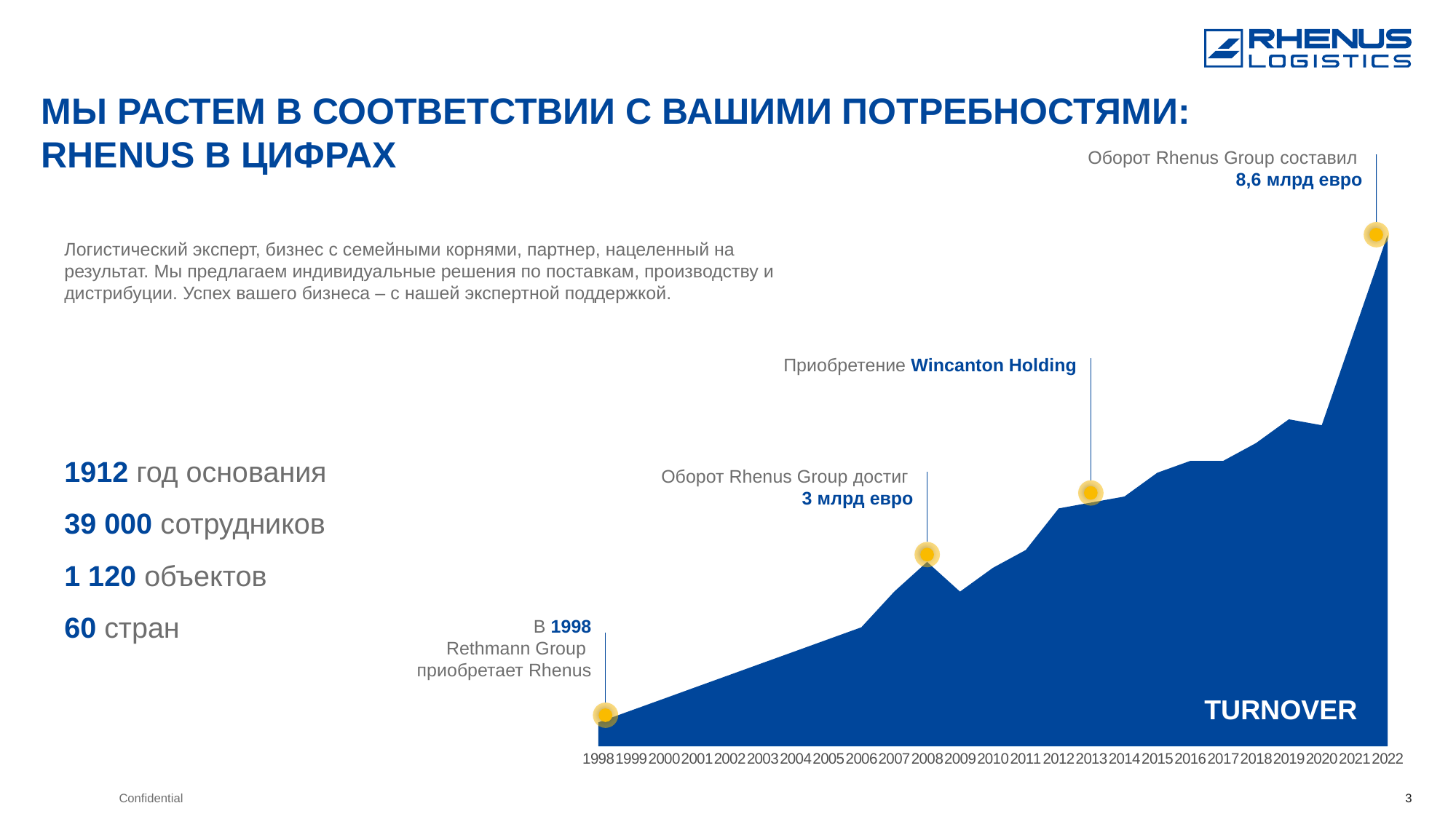
In which year is the acquisition of Wincanton Holding marked on the chart? 2013 What turnover did Rhenus Group reach in 2008 according to the annotation? 3 млрд евро Which year has the lowest turnover on the chart? 1998 What was the Rhenus Group turnover in 2022 according to the annotation? 8,6 млрд евро Which is larger, the turnover in 2008 or in 2009? 2008 Does the turnover generally rise or fall from 1998 to 2022? rise Which year has the highest turnover on the chart? 2022 What kind of chart is shown on the slide? area chart What is the first year shown on the x axis of the chart? 1998 How many years are shown on the x axis of the chart? 25 What label is printed inside the chart area? TURNOVER